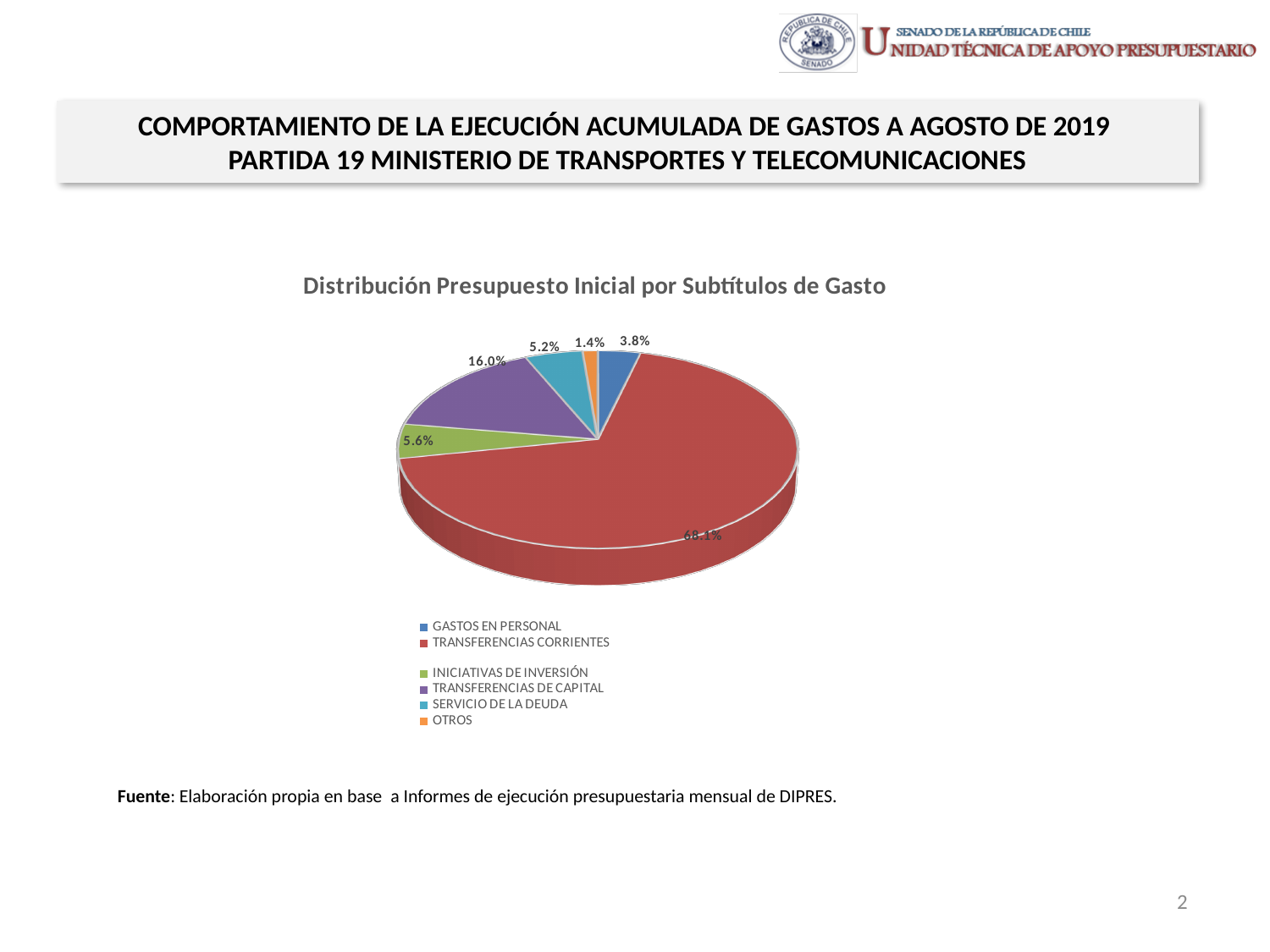
What is the value shown for SERVICIO DE LA DEUDA? 5.2% What share of the pie does TRANSFERENCIAS DE CAPITAL represent? 16.0% What is the value shown for INICIATIVAS DE INVERSIÓN? 5.6% Which category has the smallest share of the pie? OTROS What is the difference between the shares of TRANSFERENCIAS CORRIENTES and TRANSFERENCIAS DE CAPITAL? 52.1% Which is larger, the share for GASTOS EN PERSONAL or the share for OTROS? GASTOS EN PERSONAL How many categories does the legend list? 6 What is the value shown for GASTOS EN PERSONAL? 3.8% What type of chart is shown on the slide? Pie chart Which category has the largest share of the pie? TRANSFERENCIAS CORRIENTES What share of the pie does TRANSFERENCIAS CORRIENTES represent? 68.1% What is the title of the chart? Distribución Presupuesto Inicial por Subtítulos de Gasto